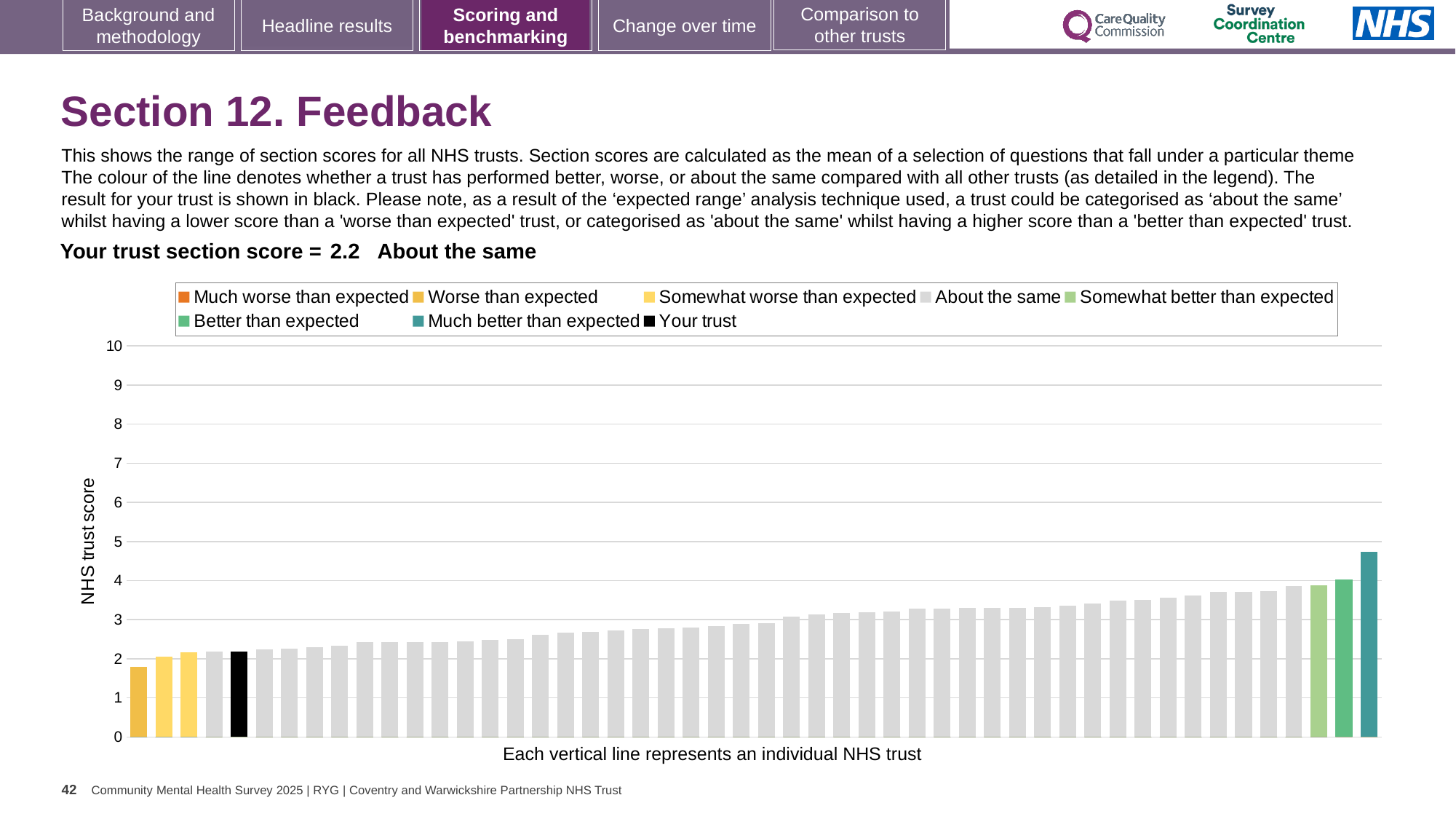
Is the bar for your trust higher or lower than the leftmost bar? higher What is the section score for your trust shown on the slide? 2.2 Do the bar values rise or fall from left to right along the x axis? rise Which legend category does the shortest bar belong to? Worse than expected Which category is your trust's section score placed in? About the same What is the label on the vertical axis of the chart? NHS trust score Which legend category does the tallest bar belong to? Much better than expected How many entries does the chart legend list? 8 What kind of chart is shown on the slide? bar chart Is the value of the leftmost bar greater or less than 2? less Is the value of the tallest bar greater or less than 4? greater Is the value for your trust greater or less than 3? less